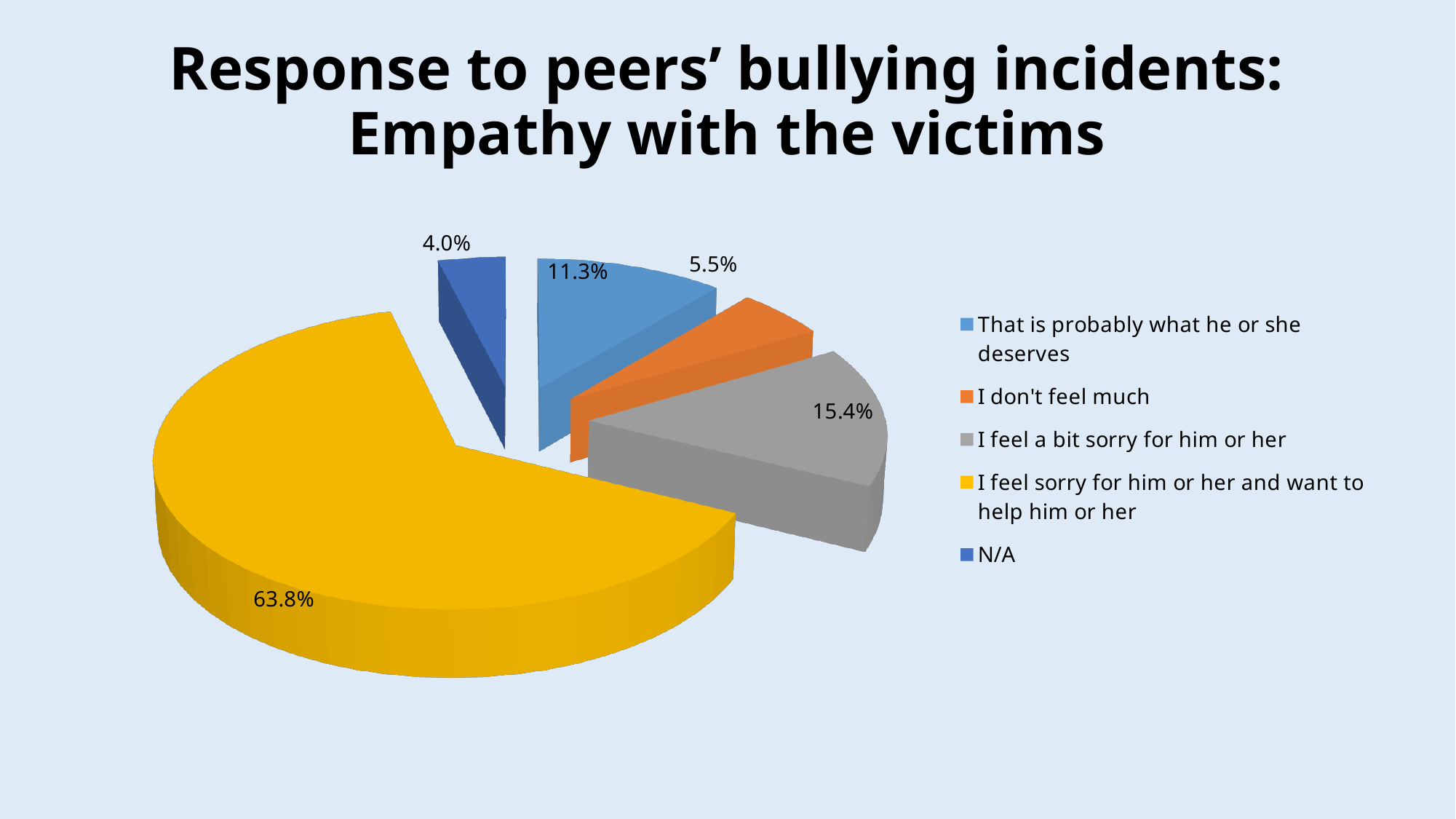
What percentage of responses were "I feel a bit sorry for him or her"? 15.4% What colour is the slice for "I feel a bit sorry for him or her"? gray What kind of chart is shown on the slide? pie chart How many categories does the legend list? 5 What percentage of responses were "I don't feel much"? 5.5% Which response category has the smallest share of the pie? N/A What is the difference in percentage points between "I feel a bit sorry for him or her" and "That is probably what he or she deserves"? 4.1 What percentage of responses were "I feel sorry for him or her and want to help him or her"? 63.8% What percentage of responses were "That is probably what he or she deserves"? 11.3% Which is larger: the share for "I don't feel much" or the share for N/A? I don't feel much What percentage of responses were N/A? 4.0% Which response category has the largest share of the pie? I feel sorry for him or her and want to help him or her